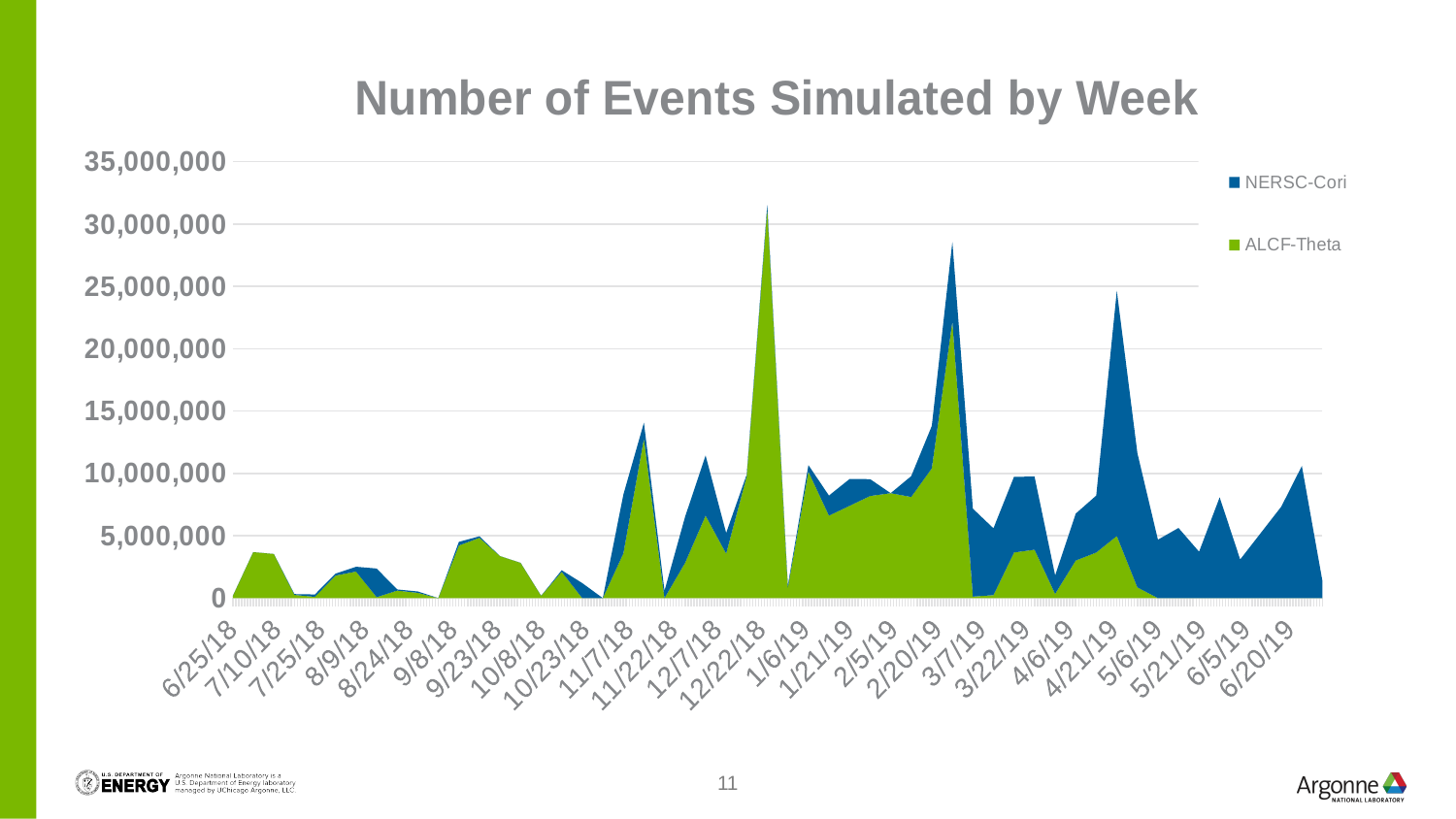
What is the highest value shown on the y axis? 35,000,000 Is the total number of events at the peak near 12/22/18 greater or less than 25,000,000? greater What is the title of the chart? Number of Events Simulated by Week Which series is shown in green? ALCF-Theta Is the total number of events at the peak near 4/21/19 greater or less than 20,000,000? greater Is the total number of events at 7/10/18 greater or less than 5,000,000? less What is the last date label on the x axis? 6/20/19 How many date labels are shown on the x axis? 25 How many series does the legend list? 2 What is the first date label on the x axis? 6/25/18 What kind of chart is shown on the slide? Area chart